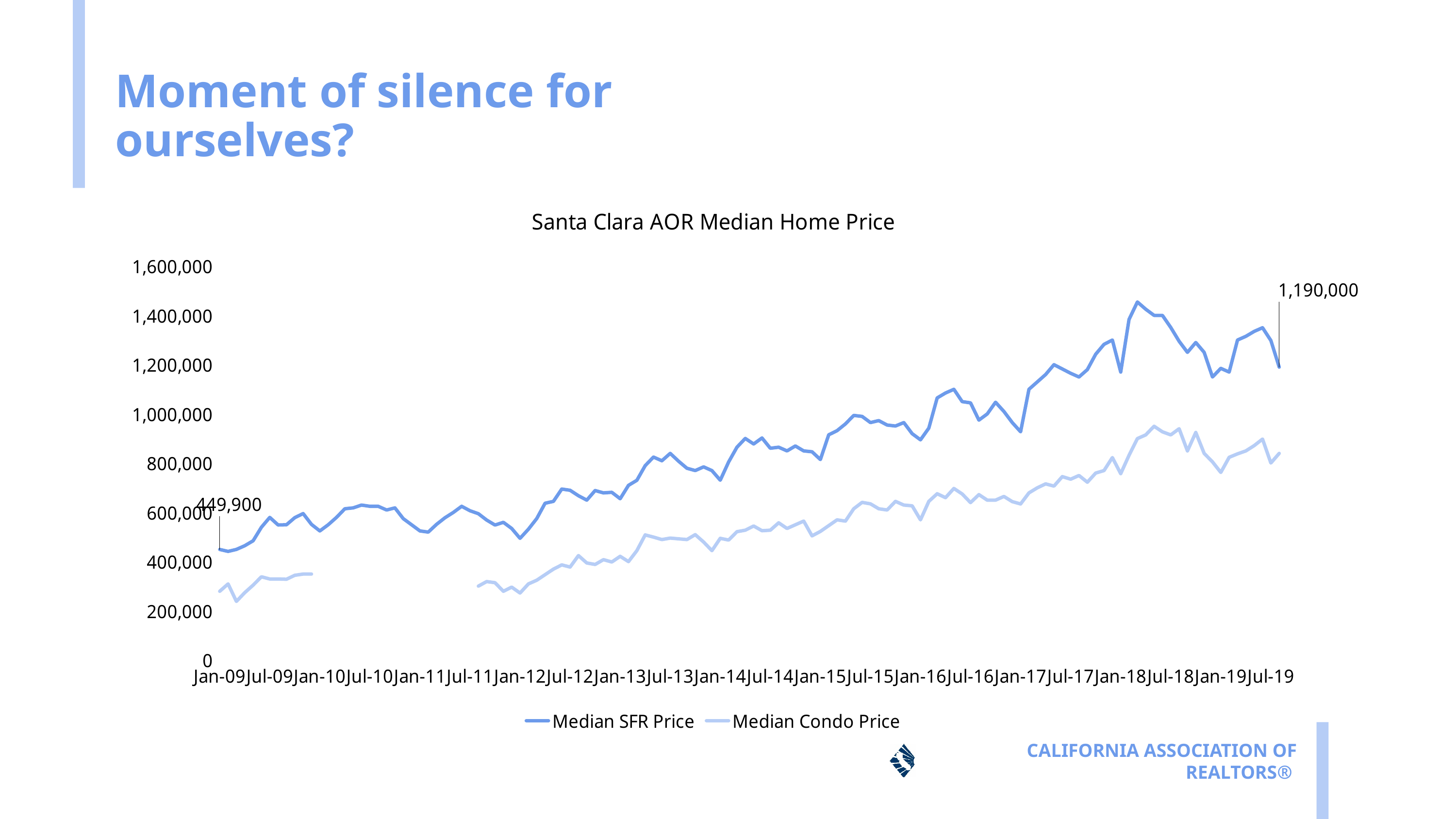
What kind of chart is shown on the slide? line chart Is the highest point of the Median SFR Price line greater or less than 1,400,000? greater Is the Median Condo Price at Jan-09 greater or less than 400,000? less By how much did the Median SFR Price change between the labelled start value (449,900) and the labelled end value (1,190,000)? 740,100 Does the Median SFR Price generally rise or fall from Jan-09 to Jul-19? rise What is the labelled Median SFR Price at the end of the series? 1,190,000 Is the Median Condo Price at the end of the series (Jul-19) greater or less than 1,000,000? less What are the two series named in the legend? Median SFR Price and Median Condo Price How many series does the legend list? 2 What is the labelled Median SFR Price at the start of the series (Jan-09)? 449,900 What is the title of the chart? Santa Clara AOR Median Home Price Which series is higher throughout the chart, Median SFR Price or Median Condo Price? Median SFR Price